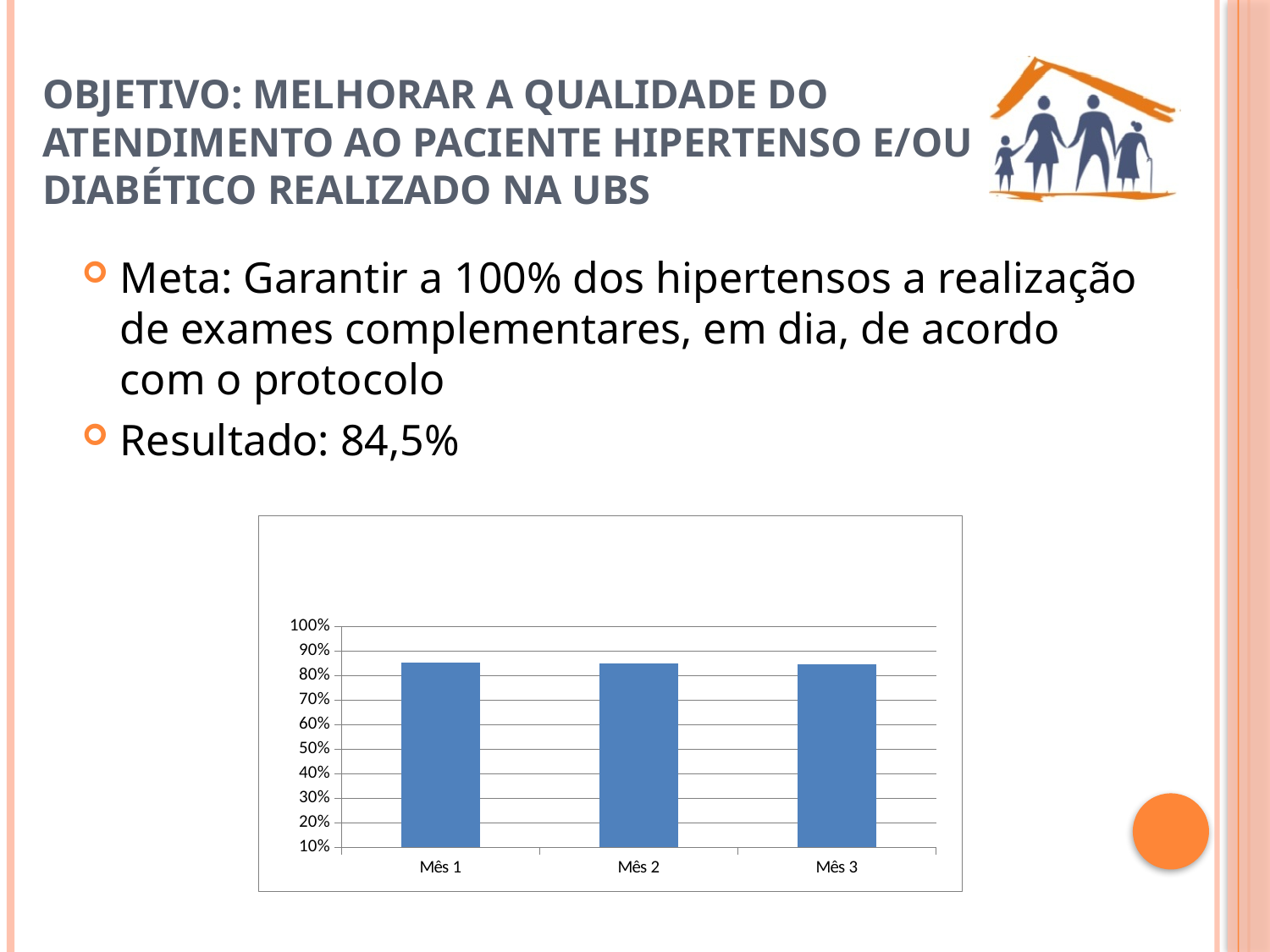
What is the label of the first category on the x axis? Mês 1 Is the value for Mês 3 greater or less than 50%? greater What is the highest tick value shown on the y axis of the chart? 100% Is the value for Mês 2 greater or less than 90%? less What kind of chart is shown on the slide? bar chart How many categories are plotted on the x axis of the chart? 3 Do the bar values change noticeably from Mês 1 to Mês 3, or stay roughly the same? stay roughly the same Is the value for Mês 3 greater or less than 80%? greater